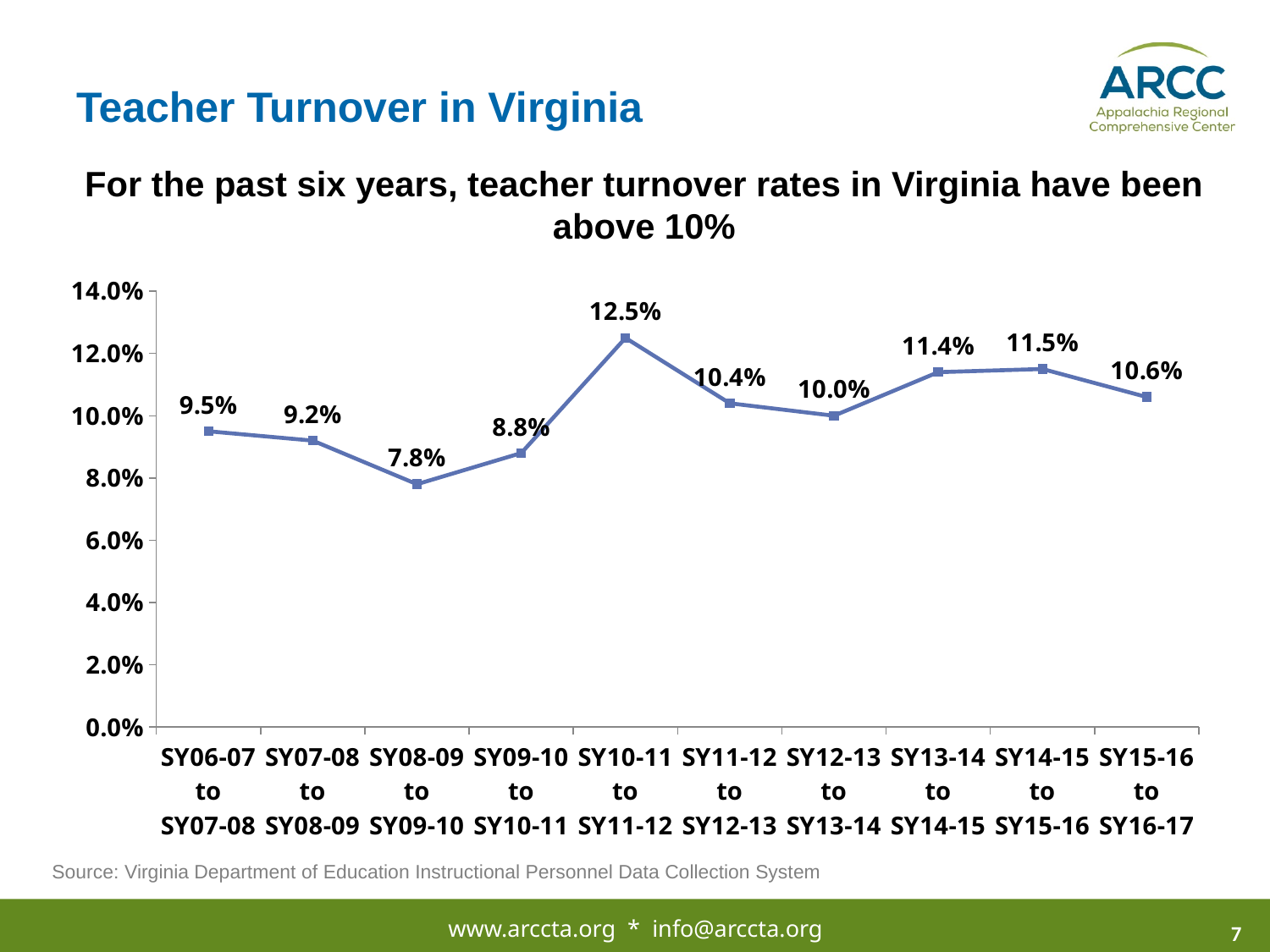
Which is larger, the turnover rate for SY06-07 to SY07-08 or for SY13-14 to SY14-15? SY13-14 to SY14-15 Is the turnover rate for SY09-10 to SY10-11 greater or less than 10.0%? less What is the teacher turnover rate for SY10-11 to SY11-12? 12.5% Which period has the lowest teacher turnover rate? SY08-09 to SY09-10 Which period has the highest teacher turnover rate? SY10-11 to SY11-12 What kind of chart is shown on the slide? line chart What is the difference between the turnover rate for SY10-11 to SY11-12 and the rate for SY11-12 to SY12-13? 2.1% Does the turnover rate rise or fall from SY08-09 to SY09-10 through SY10-11 to SY11-12? rise How many periods are plotted on the chart? 10 What is the teacher turnover rate for SY08-09 to SY09-10? 7.8% What is the title of the slide containing the chart? Teacher Turnover in Virginia What is the teacher turnover rate for SY15-16 to SY16-17? 10.6%